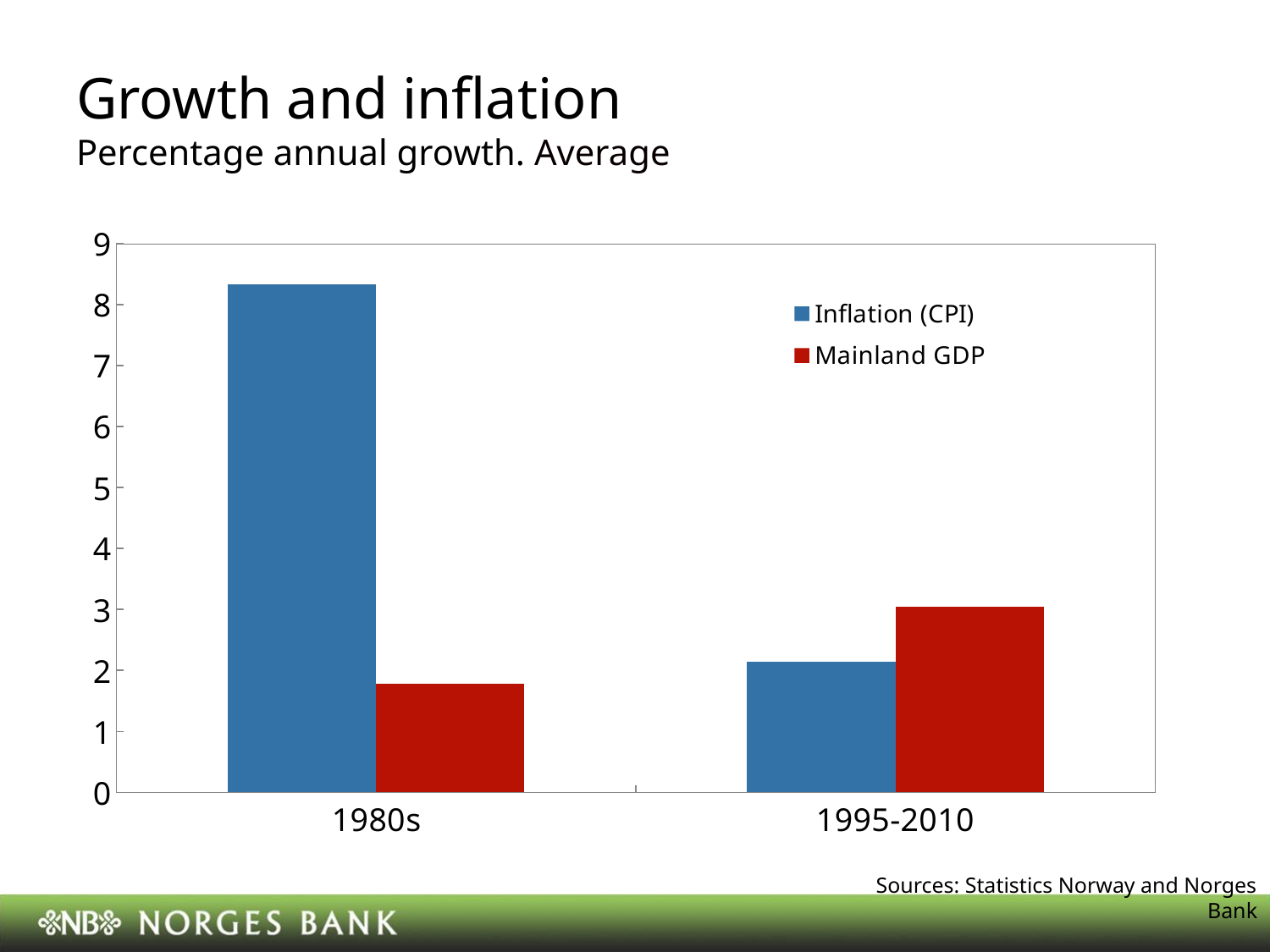
Which colour represents Mainland GDP in the legend? Red Which series and period has the lowest bar in the chart? Mainland GDP in the 1980s In the 1980s, which is larger: Inflation (CPI) or Mainland GDP? Inflation (CPI) Does Inflation (CPI) rise or fall from the 1980s to 1995-2010? Fall In 1995-2010, which is larger: Inflation (CPI) or Mainland GDP? Mainland GDP What kind of chart is shown on the slide? Bar chart Which series and period has the highest bar in the chart? Inflation (CPI) in the 1980s How many categories are shown on the x axis? 2 Is the value for Mainland GDP in 1995-2010 greater or less than 4? less Is the value for Inflation (CPI) in the 1980s greater or less than 8? greater Is the value for Mainland GDP in the 1980s greater or less than 2? less How many series does the legend list? 2